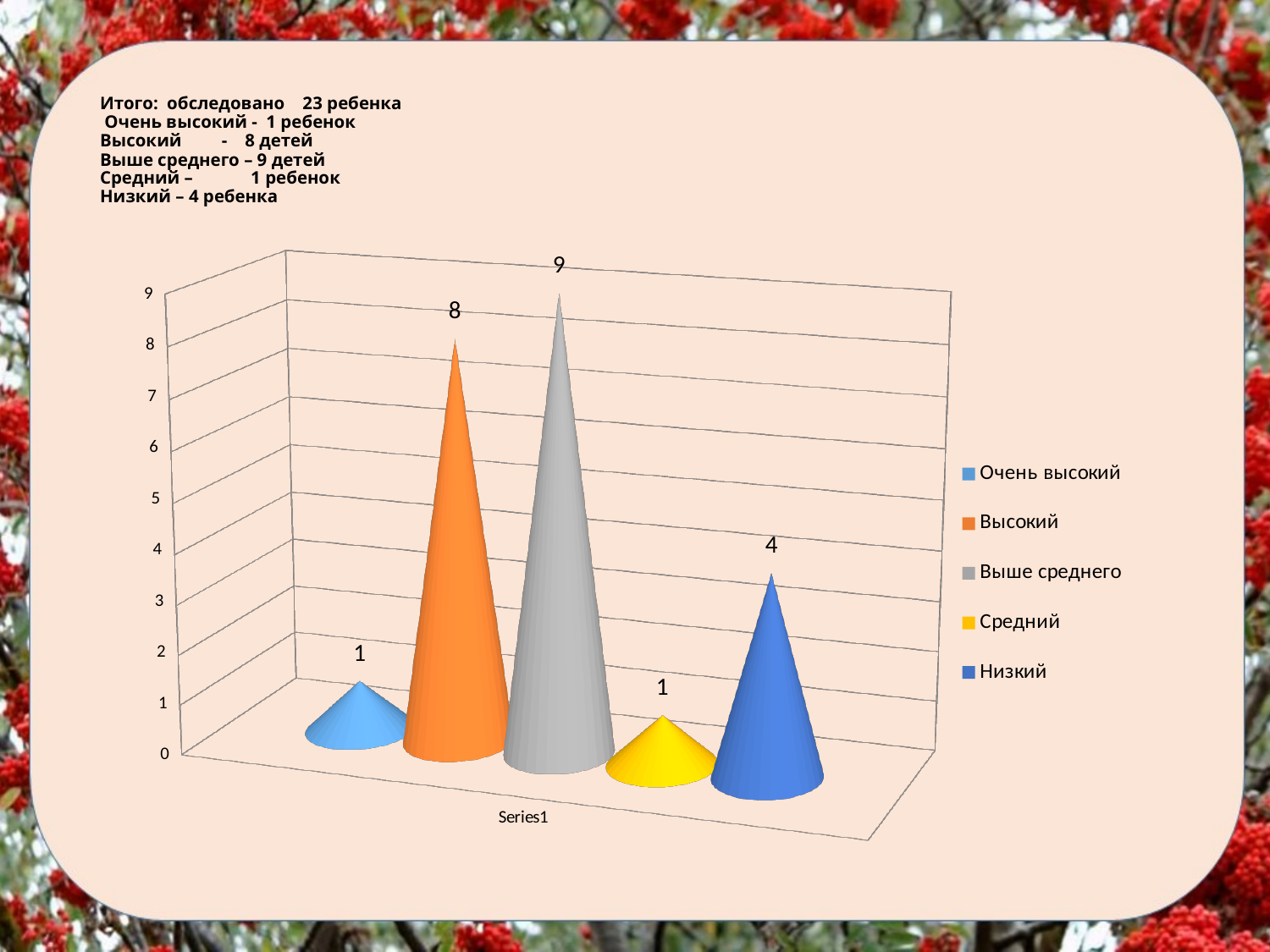
What colour is the bar for Средний? yellow What is the difference between the values for Высокий and Средний? 7 What is the value for Низкий? 4 What is the value for Высокий? 8 What is the value for Выше среднего? 9 What is the value for Очень высокий? 1 How many entries does the legend list? 5 What kind of chart is shown on the slide? bar chart What is the difference between the values for Выше среднего and Низкий? 5 Is the value for Низкий greater or less than 5? less Which category has the highest value? Выше среднего Which is larger, the value for Высокий or the value for Низкий? Высокий